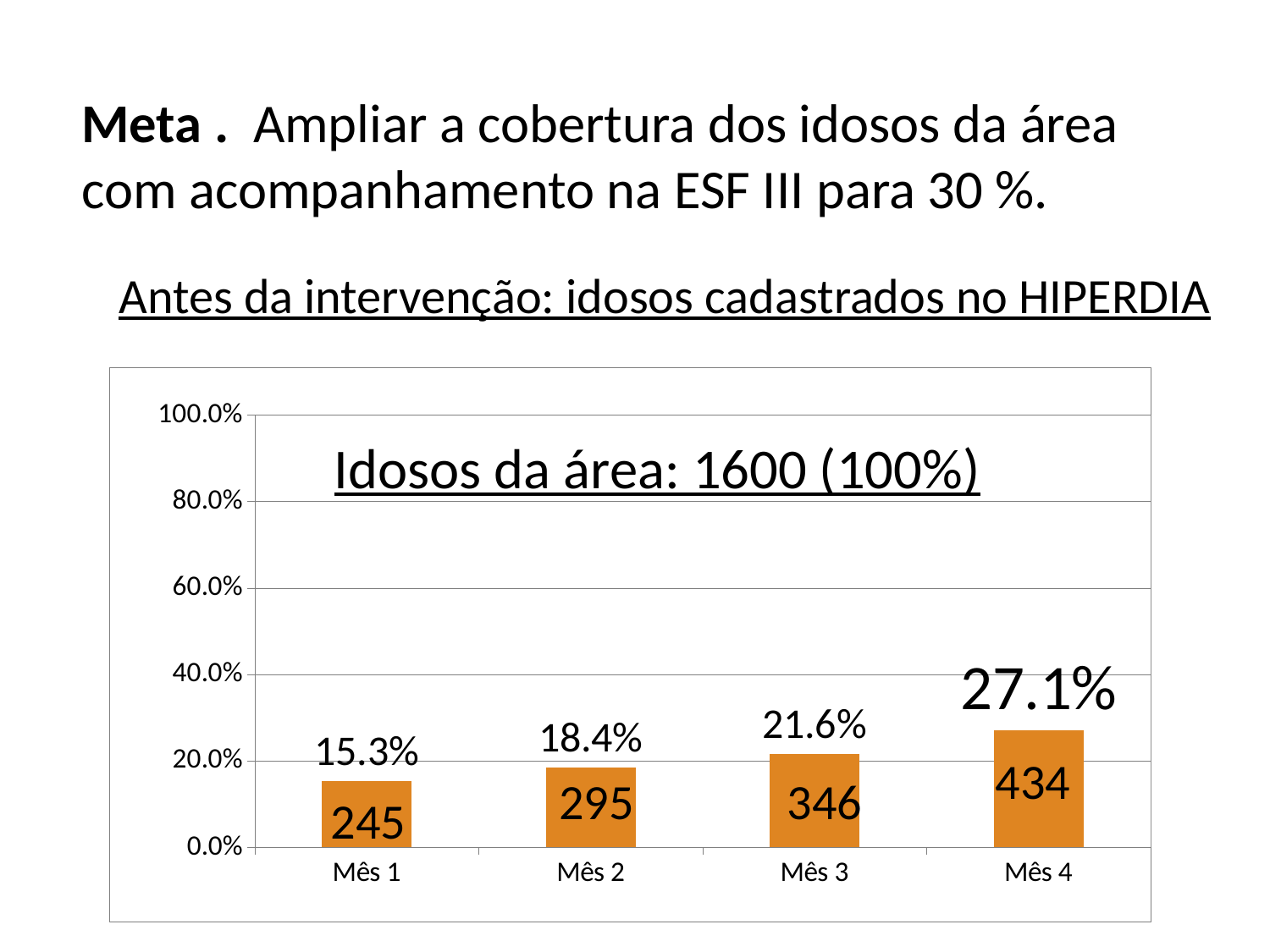
Which month has the highest percentage? Mês 4 What count is printed inside the bar for Mês 2? 295 What kind of chart is shown? Bar chart Do the percentages rise or fall from Mês 1 to Mês 4? Rise Which month has the lowest percentage? Mês 1 What is the percentage value shown for Mês 3? 21.6% What is the difference in percentage points between Mês 4 and Mês 1? 11.8 What is the difference between the counts for Mês 3 and Mês 2? 51 What is the percentage value shown for Mês 1? 15.3% How many months are shown on the x axis? 4 What count is printed inside the bar for Mês 4? 434 Which is larger, the percentage for Mês 2 or for Mês 3? Mês 3